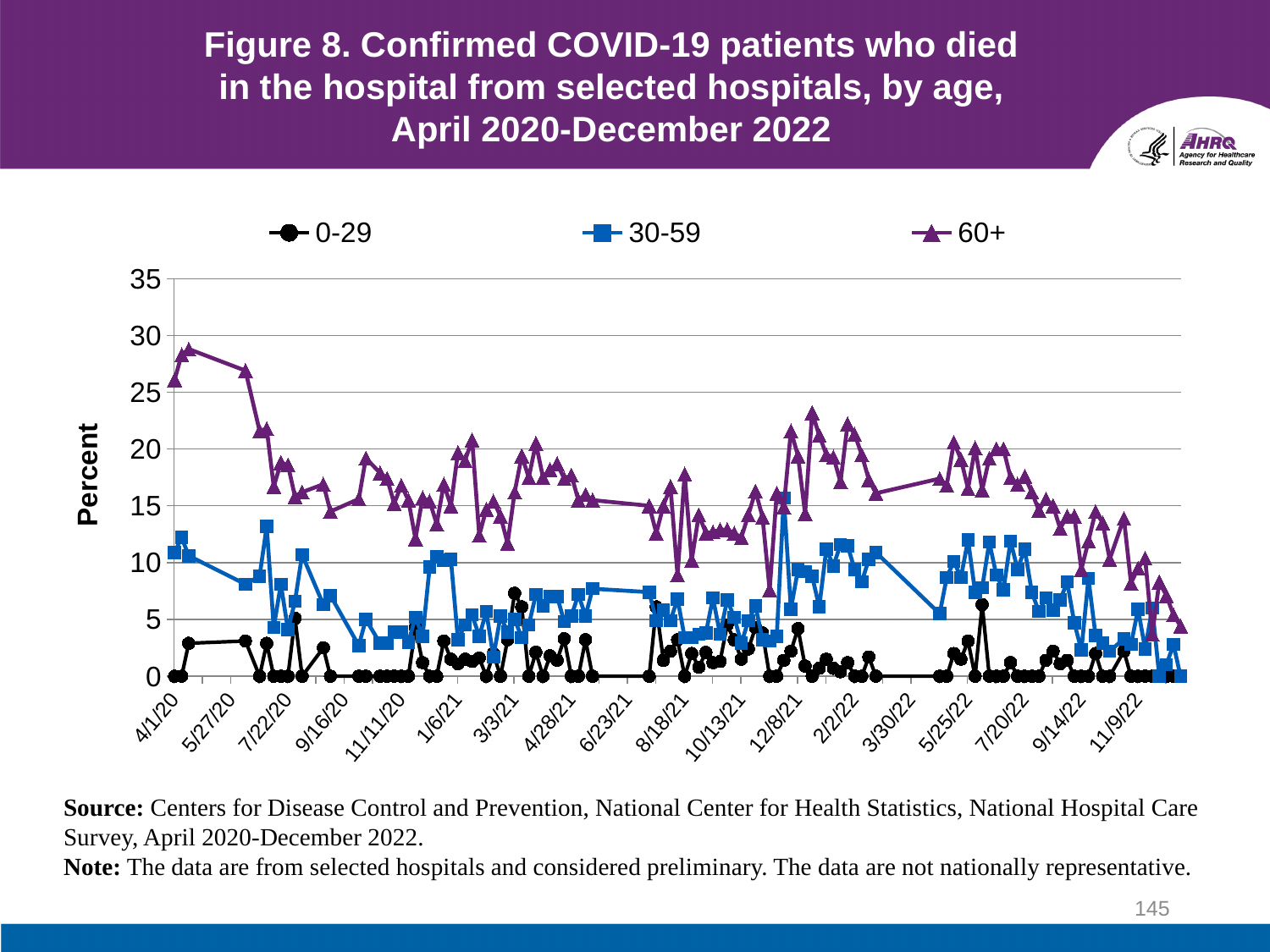
Is the highest value reached by the 0-29 series greater or less than 10? less Which marker shape is used for the 60+ series in the legend? triangle How many series does the legend list? 3 What kind of chart is shown on the slide? line chart Is the value for the 30-59 series at 4/1/20 greater or less than 5? greater What is the label on the vertical axis? Percent Which age group series has the lowest values across the chart? 0-29 Is the value for the 60+ series at 11/9/22 greater or less than 15? less Does the 60+ series rise or fall between 4/1/20 and 7/22/20? fall Which age group series has the highest values across the chart? 60+ At 4/1/20, which series has the larger value, 60+ or 30-59? 60+